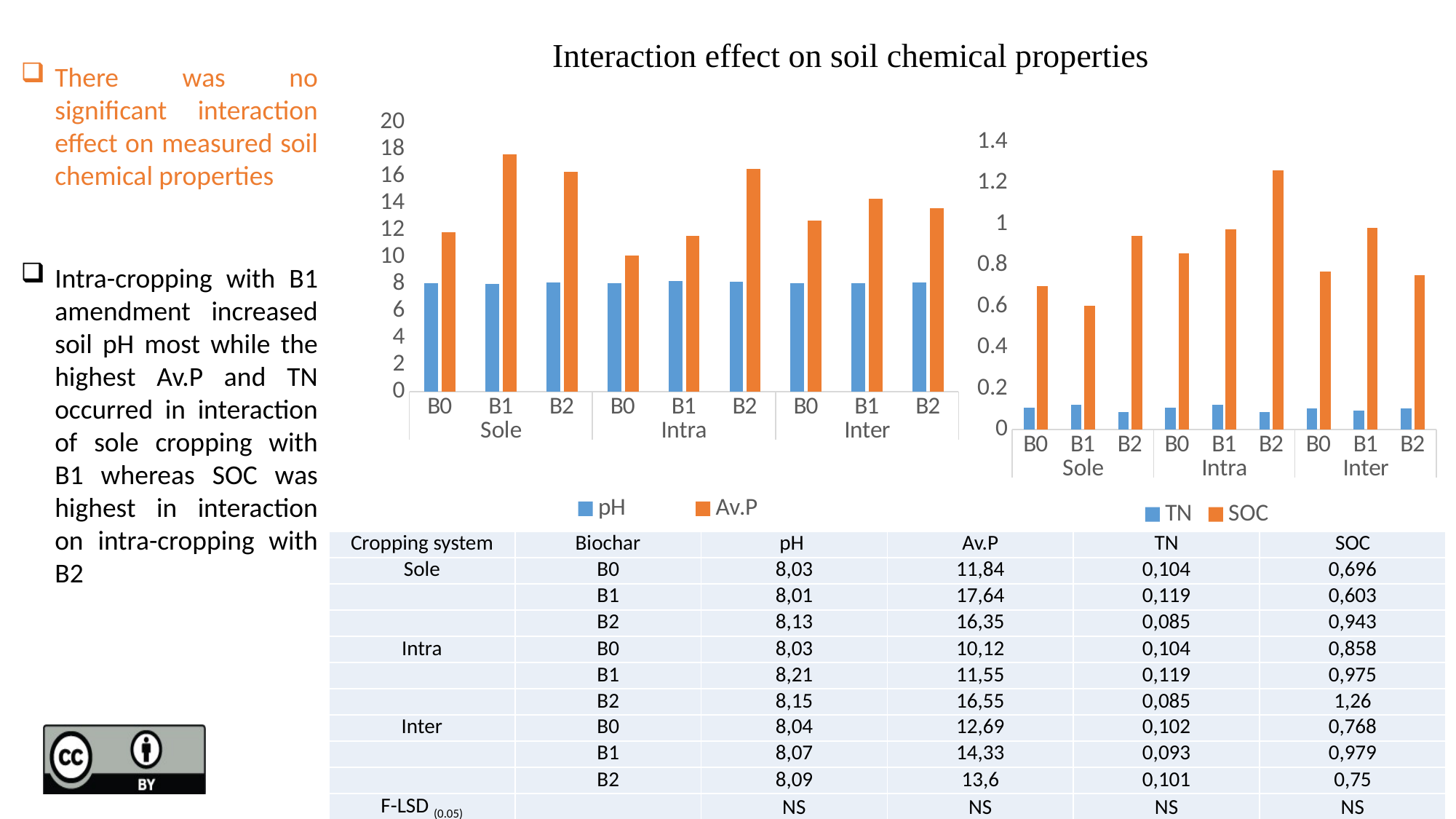
In the right chart, which biochar treatment and cropping system has the lowest SOC bar? B1 under Sole In the left chart, which biochar treatment and cropping system has the highest Av.P bar? B1 under Sole In the left chart (pH and Av.P), how many series does the legend list? 2 In the left chart, which Av.P bar is larger: B2 under Sole or B1 under Inter? B2 under Sole In the left chart, is the Av.P value for B1 under Sole greater or less than 16? greater In the left chart, how many biochar categories are plotted along the x axis in total? 9 What kind of chart is the left chart showing pH and Av.P? bar chart In the right chart, which biochar treatment and cropping system has the highest SOC bar? B2 under Intra In the right chart, is the SOC value for B2 under Intra greater or less than 1? greater In the right chart (TN and SOC), how many series does the legend list? 2 In the right chart, what colour are the SOC bars? orange In the left chart, which biochar treatment and cropping system has the lowest Av.P bar? B0 under Intra